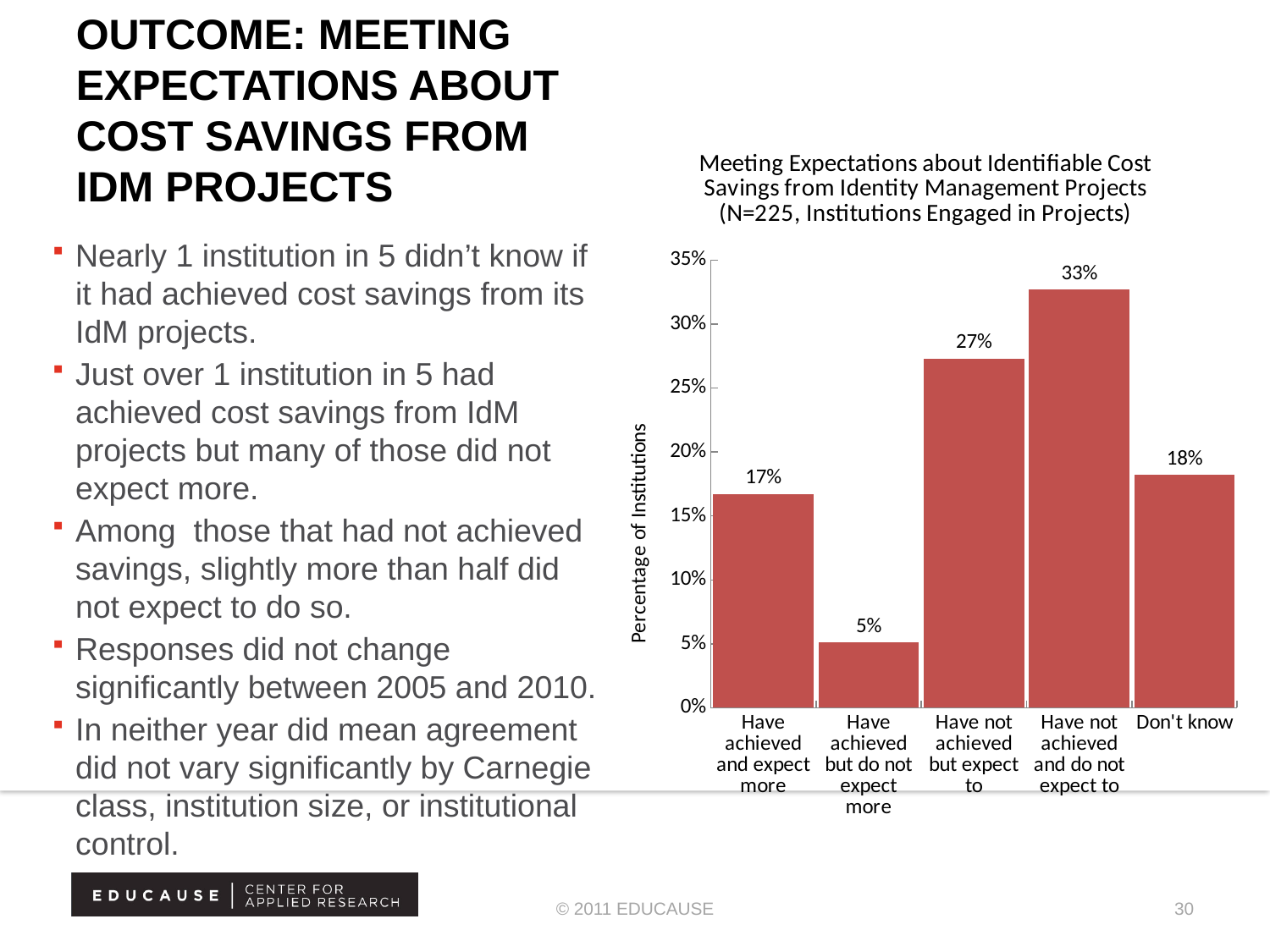
Which category has the highest percentage of institutions? Have not achieved and do not expect to Which is larger: the percentage for 'Don't know' or for 'Have achieved and expect more'? Don't know How many categories are shown on the x axis of the chart? 5 What percentage of institutions have achieved cost savings and expect more? 17% What is the difference in percentage points between 'Have not achieved and do not expect to' and 'Have not achieved but expect to'? 6 percentage points What percentage of institutions have not achieved cost savings but expect to? 27% What type of chart is shown on the slide? Bar chart What is the label of the y axis of the chart? Percentage of Institutions What percentage of institutions answered 'Don't know'? 18% What percentage of institutions have achieved cost savings but do not expect more? 5% Is the value for 'Have not achieved and do not expect to' greater or less than 30%? greater Which category has the lowest percentage of institutions? Have achieved but do not expect more